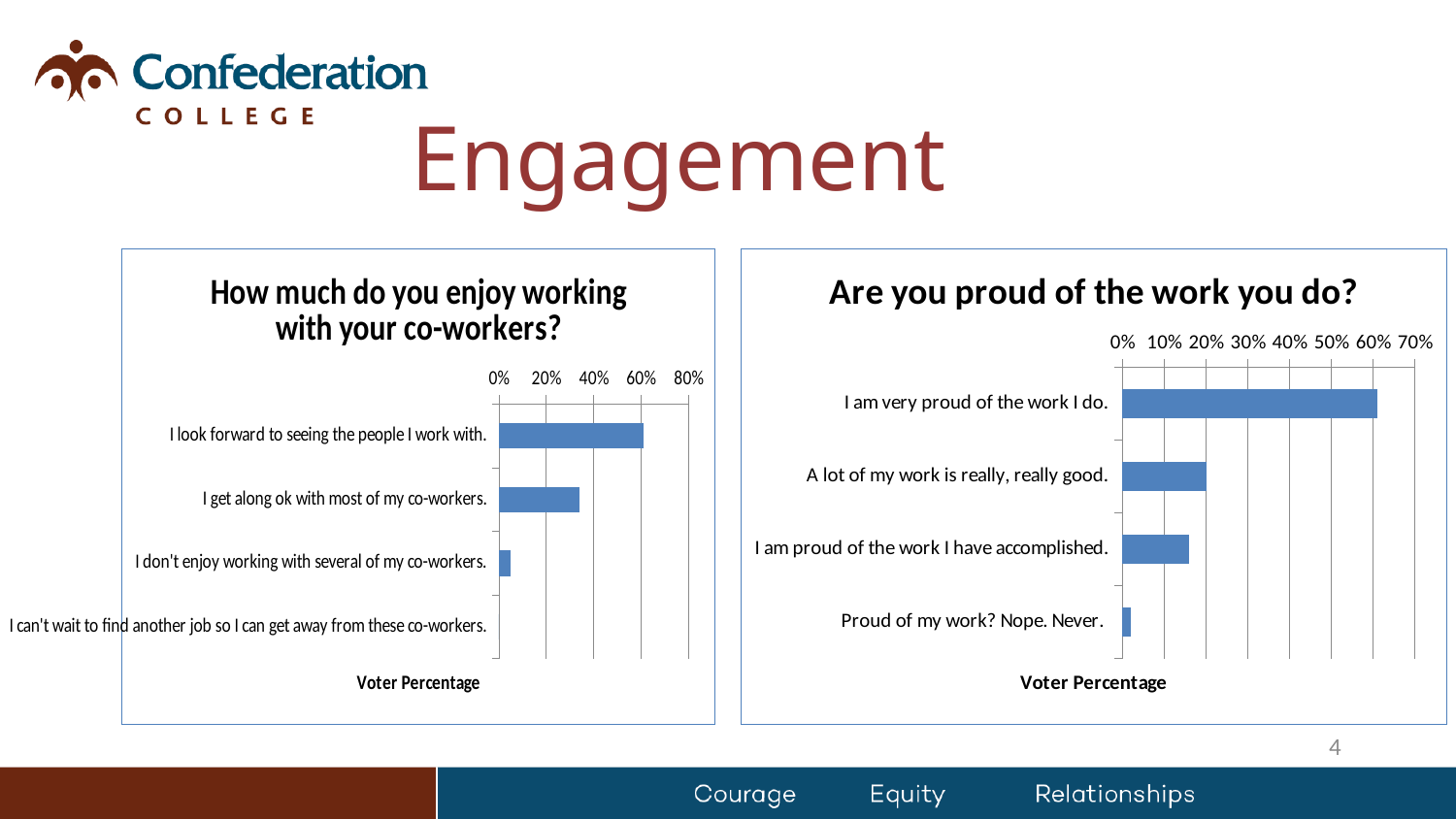
In the chart 'Are you proud of the work you do?', which response has the highest voter percentage? I am very proud of the work I do. What is the axis title shown below the bars in the chart 'Are you proud of the work you do?'? Voter Percentage How many response categories are shown in the chart 'How much do you enjoy working with your co-workers?'? 4 In the chart 'Are you proud of the work you do?', is the value for 'I am proud of the work I have accomplished.' greater or less than 20%? less In the chart 'How much do you enjoy working with your co-workers?', is the value for 'I don't enjoy working with several of my co-workers.' greater or less than 20%? less In the chart 'How much do you enjoy working with your co-workers?', is the value for 'I look forward to seeing the people I work with.' greater or less than 40%? greater In the chart 'How much do you enjoy working with your co-workers?', which response has the highest voter percentage? I look forward to seeing the people I work with. What type of chart is 'How much do you enjoy working with your co-workers?'? bar chart In the chart 'Are you proud of the work you do?', which is larger: 'A lot of my work is really, really good.' or 'Proud of my work? Nope. Never.'? A lot of my work is really, really good. In the chart 'Are you proud of the work you do?', which response has the lowest voter percentage? Proud of my work? Nope. Never.